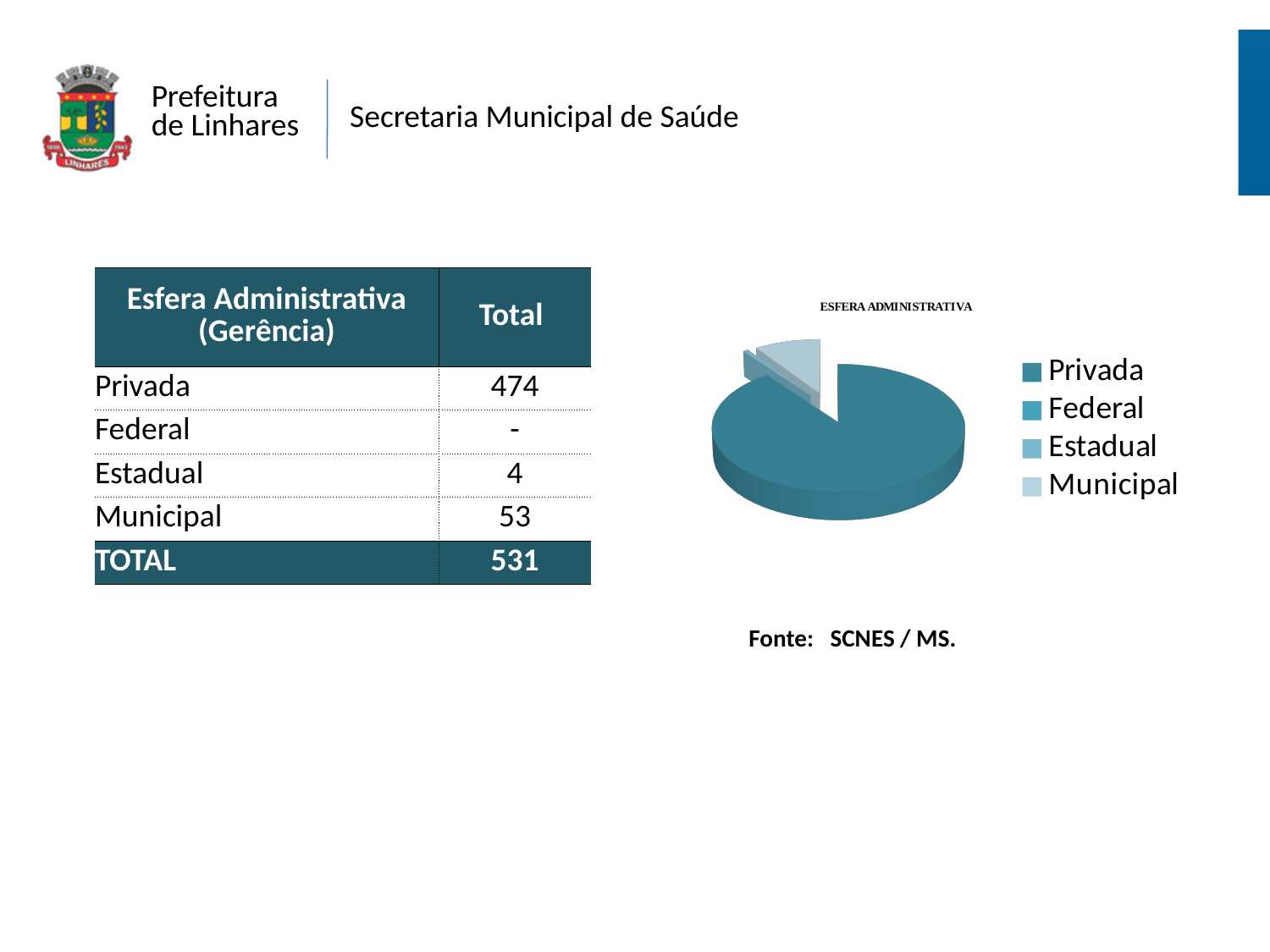
What is the title of the pie chart? ESFERA ADMINISTRATIVA What is the difference between the Municipal and Estadual totals? 49 What kind of chart is shown on the slide? pie chart What is the overall TOTAL across all administrative spheres shown on the slide? 531 What is the difference between the Privada and Municipal totals? 421 How many entries does the pie chart's legend list? 4 According to the slide, what is the total for Privada? 474 According to the slide, what is the total for Estadual? 4 Which category has the largest slice in the pie chart? Privada Which is larger, the slice for Municipal or the slice for Estadual? Municipal According to the slide, what is the total for Municipal? 53 Which category is shown with a dash (no value) in the table? Federal